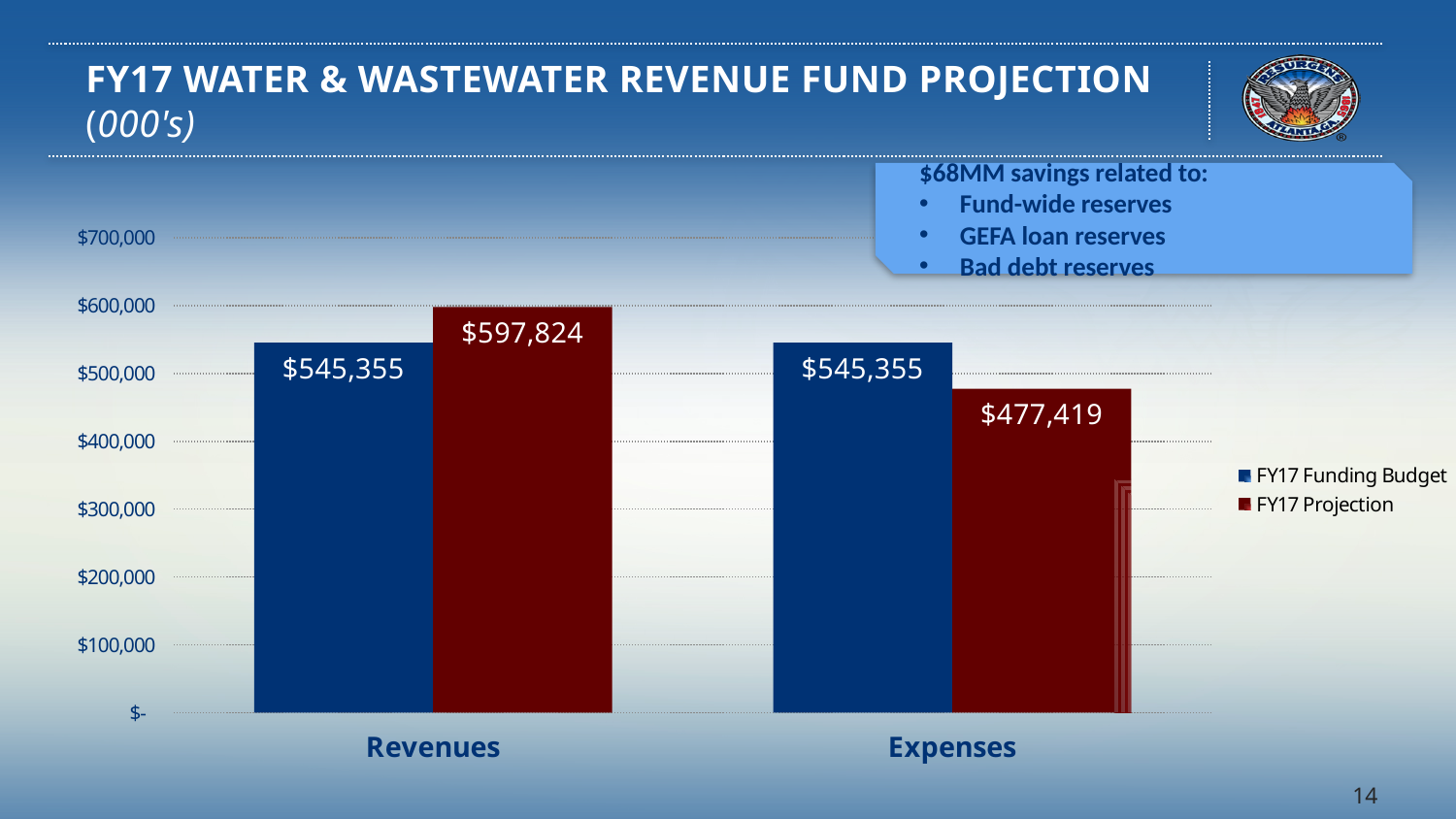
Which bar on the chart has the highest value? FY17 Projection for Revenues Which is larger for Expenses, the FY17 Funding Budget or the FY17 Projection? FY17 Funding Budget How many categories are shown on the x axis of the chart? 2 What is the FY17 Funding Budget value for Expenses? $545,355 Is the FY17 Projection value for Expenses greater or less than $500,000? less What is the FY17 Projection value for Expenses? $477,419 What is the difference between the FY17 Funding Budget and the FY17 Projection for Expenses? $67,936 What is the FY17 Projection value for Revenues? $597,824 What is the difference between the FY17 Projection and the FY17 Funding Budget for Revenues? $52,469 What kind of chart is shown on the slide? bar chart How many series does the chart legend list? 2 Which bar on the chart has the lowest value? FY17 Projection for Expenses